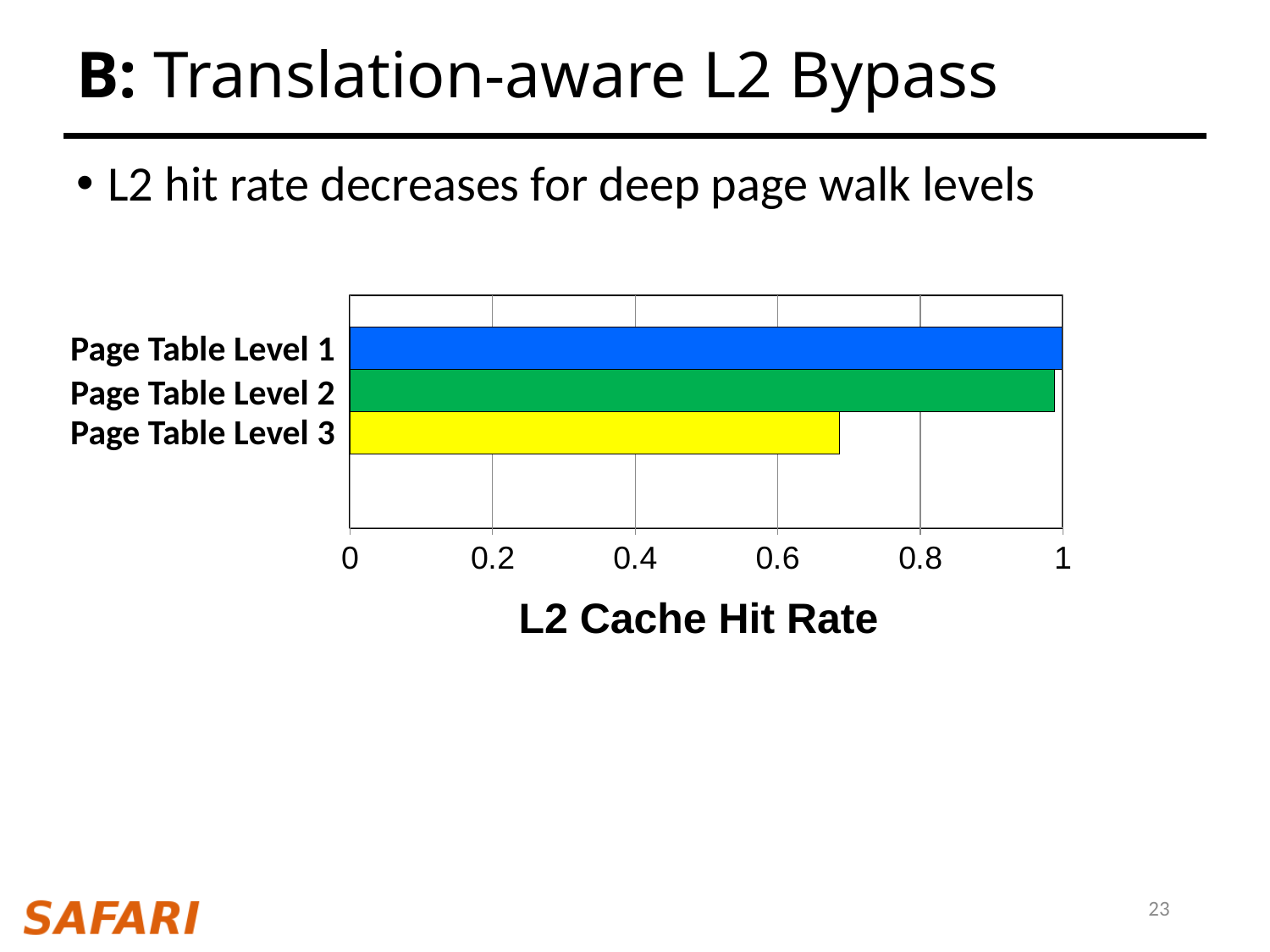
Is the L2 cache hit rate for Page Table Level 2 greater or less than 0.8? greater Is the L2 cache hit rate for Page Table Level 1 greater or less than 0.8? greater What colour is the bar for Page Table Level 3? yellow Is the L2 cache hit rate for Page Table Level 3 greater or less than 0.8? less What kind of chart is shown on the slide? bar chart Which has a higher L2 cache hit rate, Page Table Level 2 or Page Table Level 3? Page Table Level 2 How many page table levels are plotted in the chart? 3 Which page table level has the lowest L2 cache hit rate? Page Table Level 3 Which has a higher L2 cache hit rate, Page Table Level 1 or Page Table Level 3? Page Table Level 1 Does the L2 cache hit rate increase or decrease going from Page Table Level 1 to Page Table Level 3? decrease What is the title of the horizontal axis of the chart? L2 Cache Hit Rate